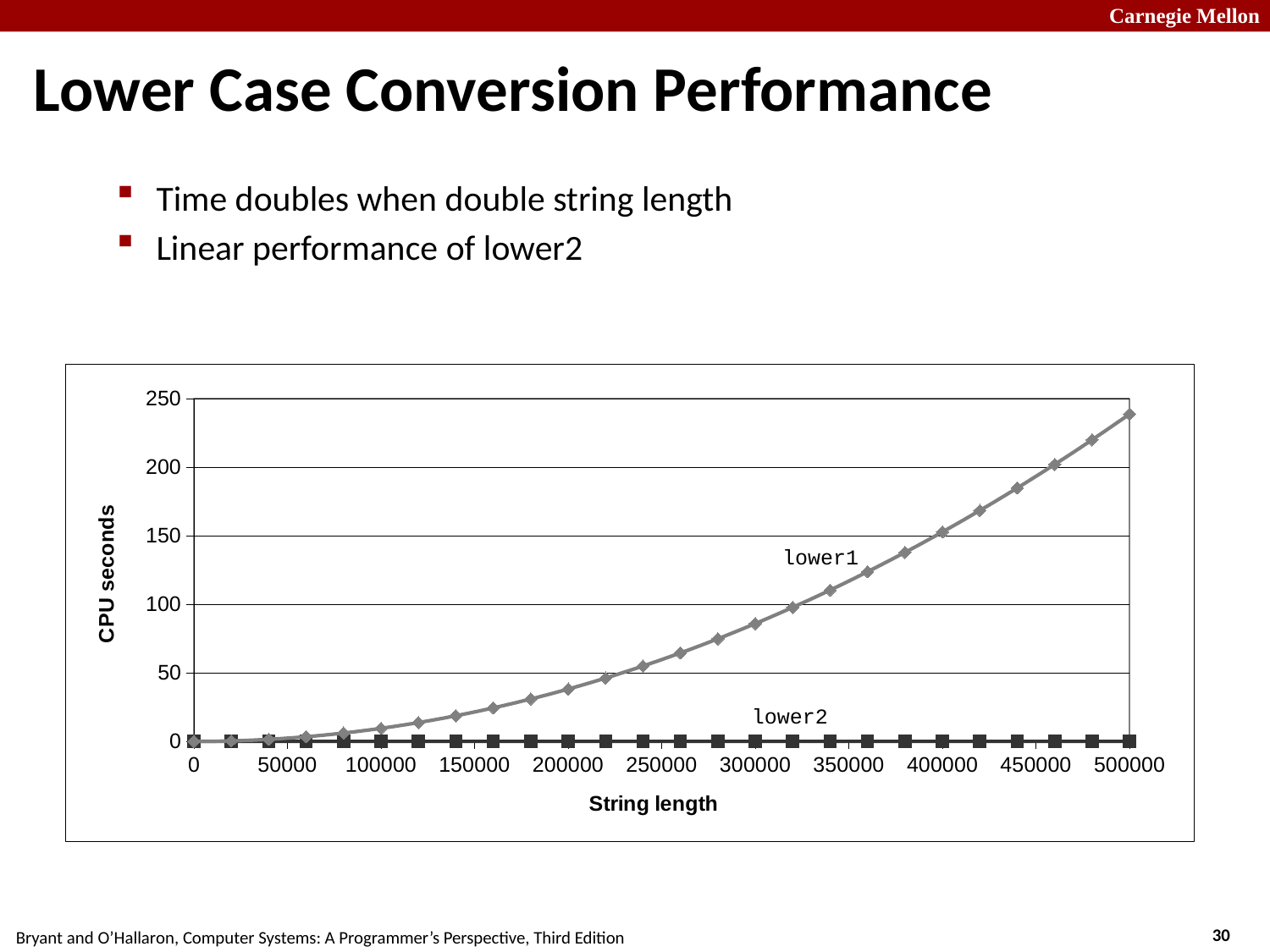
What are the names of the two series labelled on the chart? lower1 and lower2 Is the value for lower1 at string length 200000 greater or less than 50? less Is the value for lower2 at string length 500000 greater or less than 50? less Is the value for lower1 at string length 300000 greater or less than 100? less What kind of chart is shown on the slide? line chart At string length 500000, which series has the larger CPU seconds value, lower1 or lower2? lower1 How many data series are plotted on the chart? 2 How many tick labels are shown on the x axis? 11 What is the label of the y axis? CPU seconds Does the lower1 series rise or fall as string length increases? rise Which series has the highest CPU seconds value on the chart? lower1